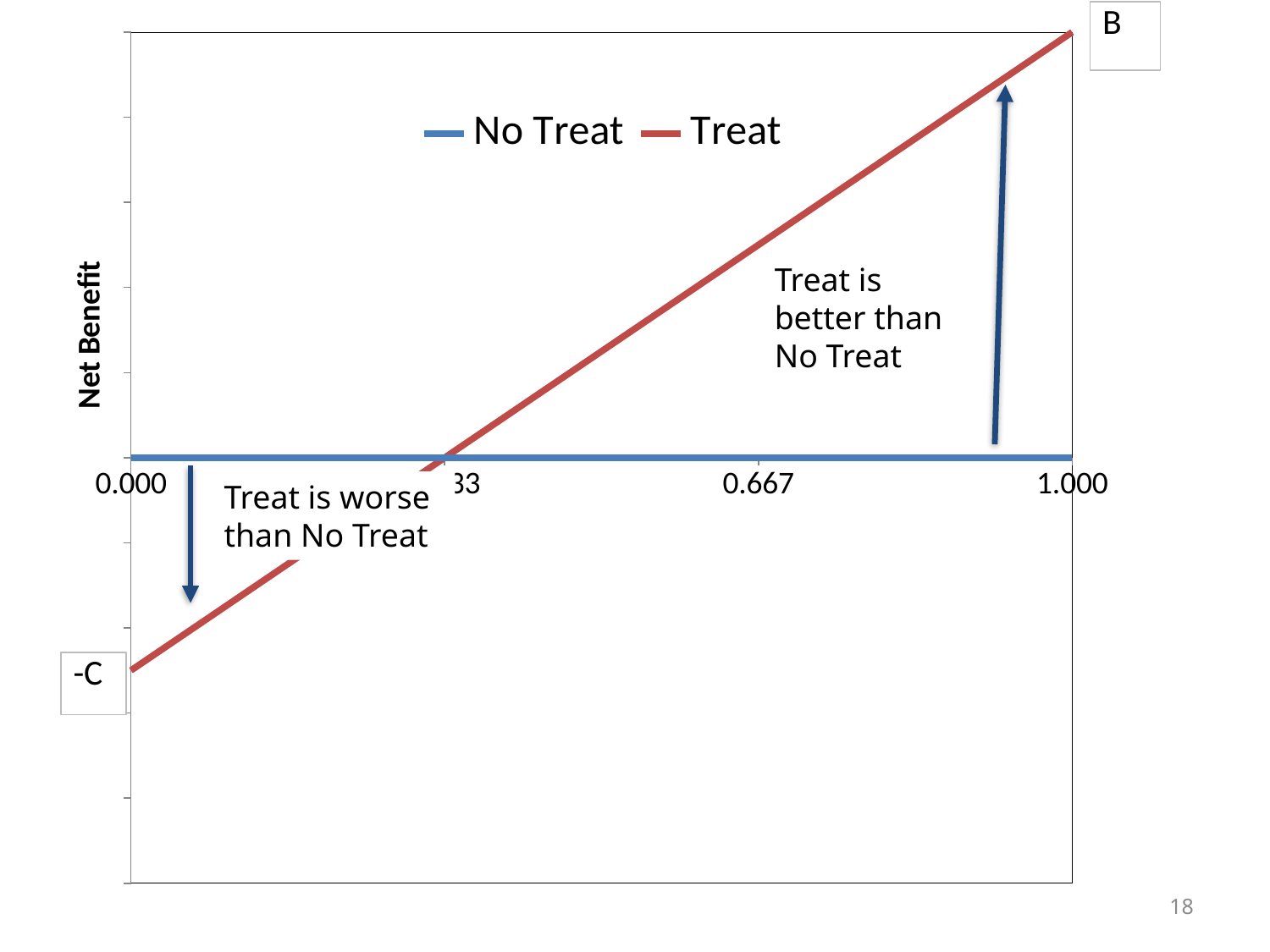
Does the No Treat line rise, fall, or stay flat across the x axis? stay flat What label marks the value of the Treat line at x = 1.000? B What are the two series named in the legend? No Treat and Treat What kind of chart is shown on the slide? line chart What label marks the value of the Treat line at x = 0.000? -C Does the Treat line rise or fall as the x-axis value increases from 0.000 to 1.000? rise What is the label on the vertical axis? Net Benefit At x = 0.667, which series has the higher Net Benefit, Treat or No Treat? Treat What is the largest value shown on the x axis? 1.000 At x = 1.000, which series has the higher Net Benefit, Treat or No Treat? Treat At x = 0.000, which series has the higher Net Benefit, Treat or No Treat? No Treat How many series does the legend list? 2